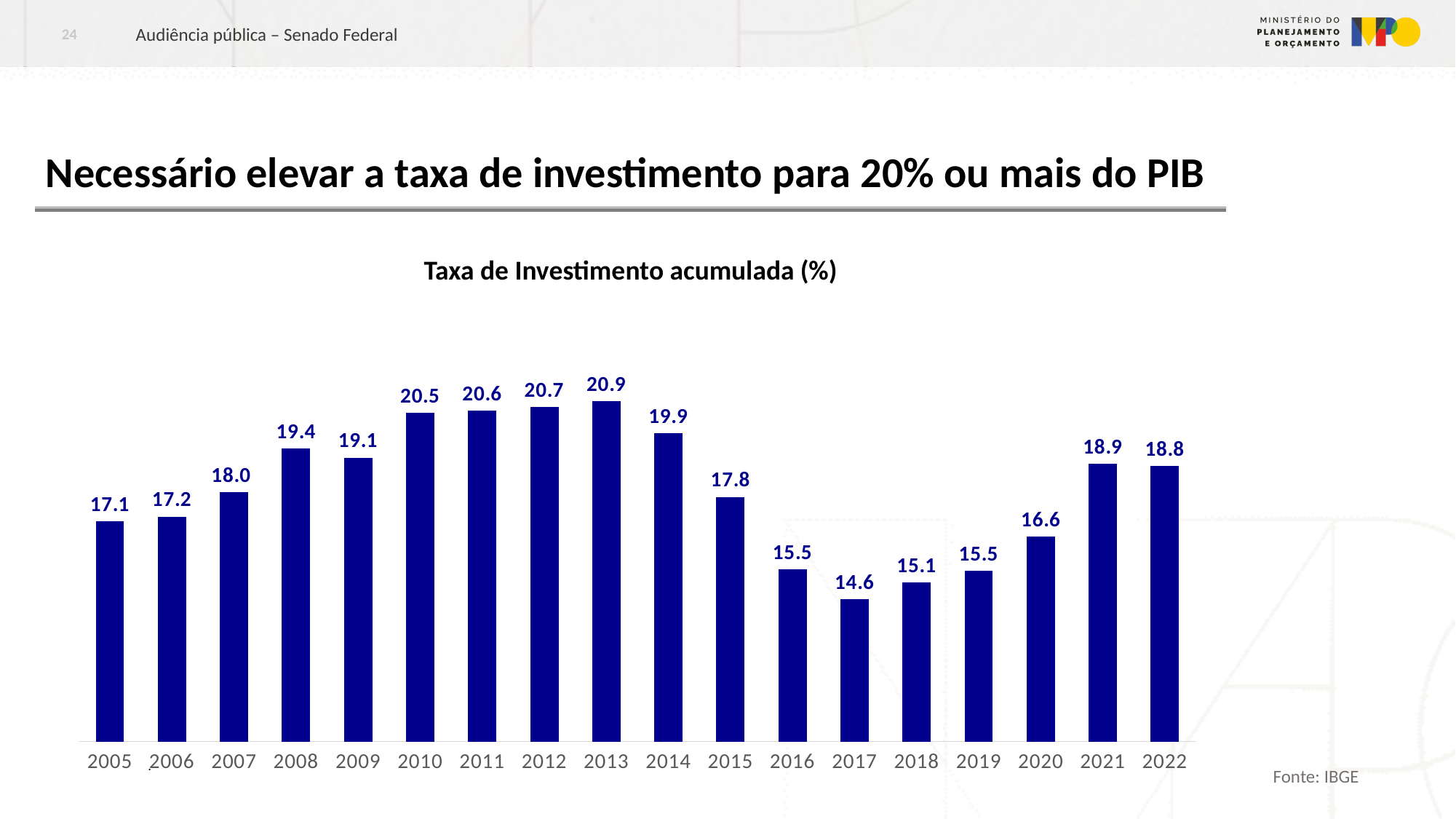
What is the source cited for the chart? IBGE Which year has the highest value? 2013 What is the value for 2022? 18.8 Do the values rise or fall from 2014 to 2017? fall What is the value for 2017? 14.6 What kind of chart is this? bar chart What is the difference between the values for 2013 and 2017? 6.3 Which year has the lowest value? 2017 How many years are shown on the x axis? 18 What is the title of the chart? Taxa de Investimento acumulada (%) What is the value for 2013? 20.9 Which is larger, the value for 2008 or the value for 2009? 2008